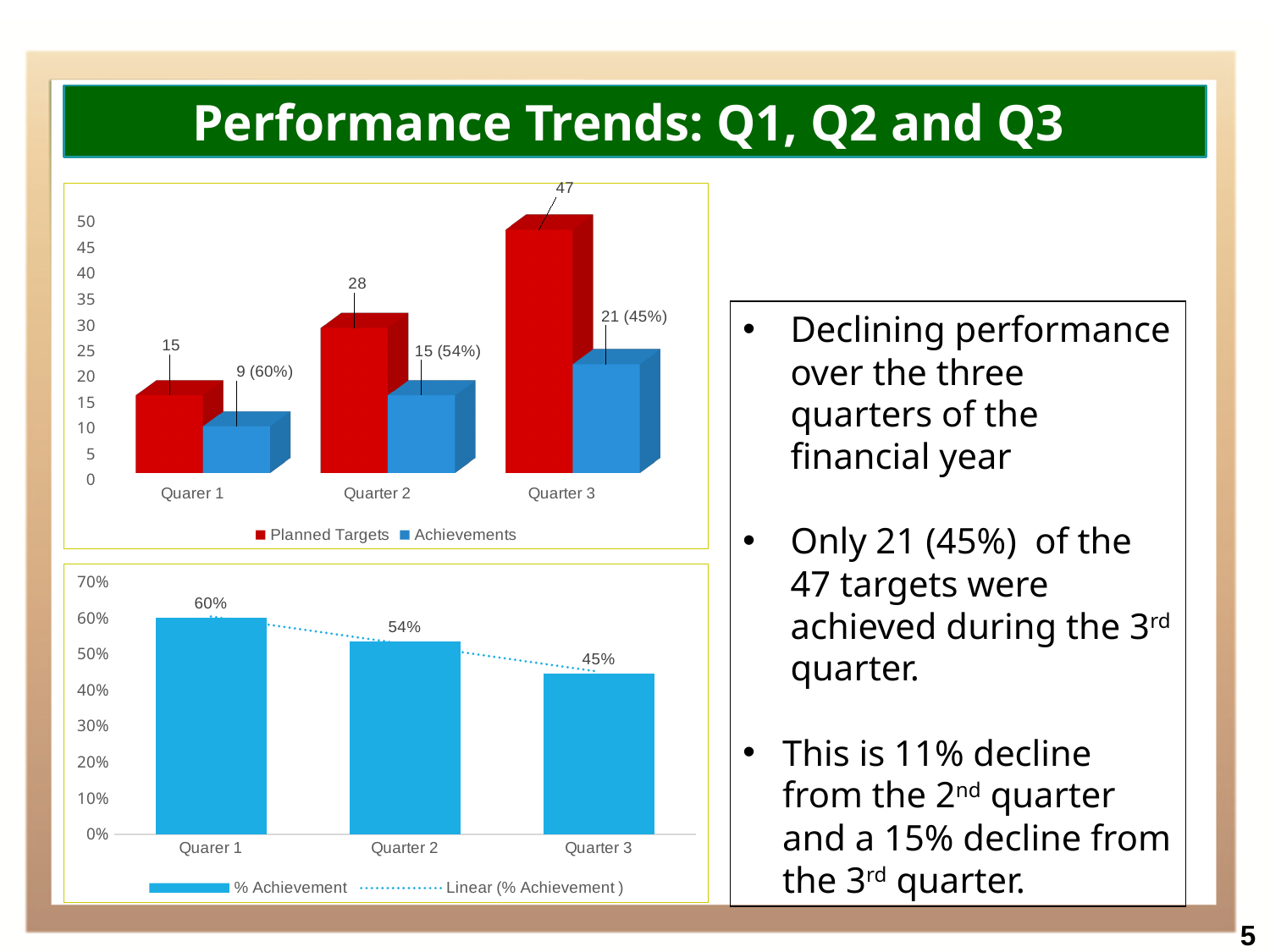
In the bottom chart, do the % Achievement values rise or fall from Quarter 1 to Quarter 3? Fall In the bottom chart, what is the difference in % Achievement between Quarter 1 and Quarter 2? 6% In the top chart, what is the Planned Targets value for Quarter 3? 47 In the top chart, which quarter has the highest Planned Targets value? Quarter 3 In the bottom chart, what is the % Achievement for Quarter 3? 45% How many quarters are shown on the x axis of the bottom chart? 3 What type of chart is the top chart? Bar chart In the top chart, what is the difference between Planned Targets and Achievements in Quarter 3? 26 In the top chart, what is the Achievements data label for Quarter 2? 15 (54%) In the top chart, what is the Planned Targets value for Quarter 2? 28 In the top chart, which is larger: Planned Targets for Quarter 2 or Achievements for Quarter 3? Planned Targets for Quarter 2 How many series does the legend of the top chart list? 2